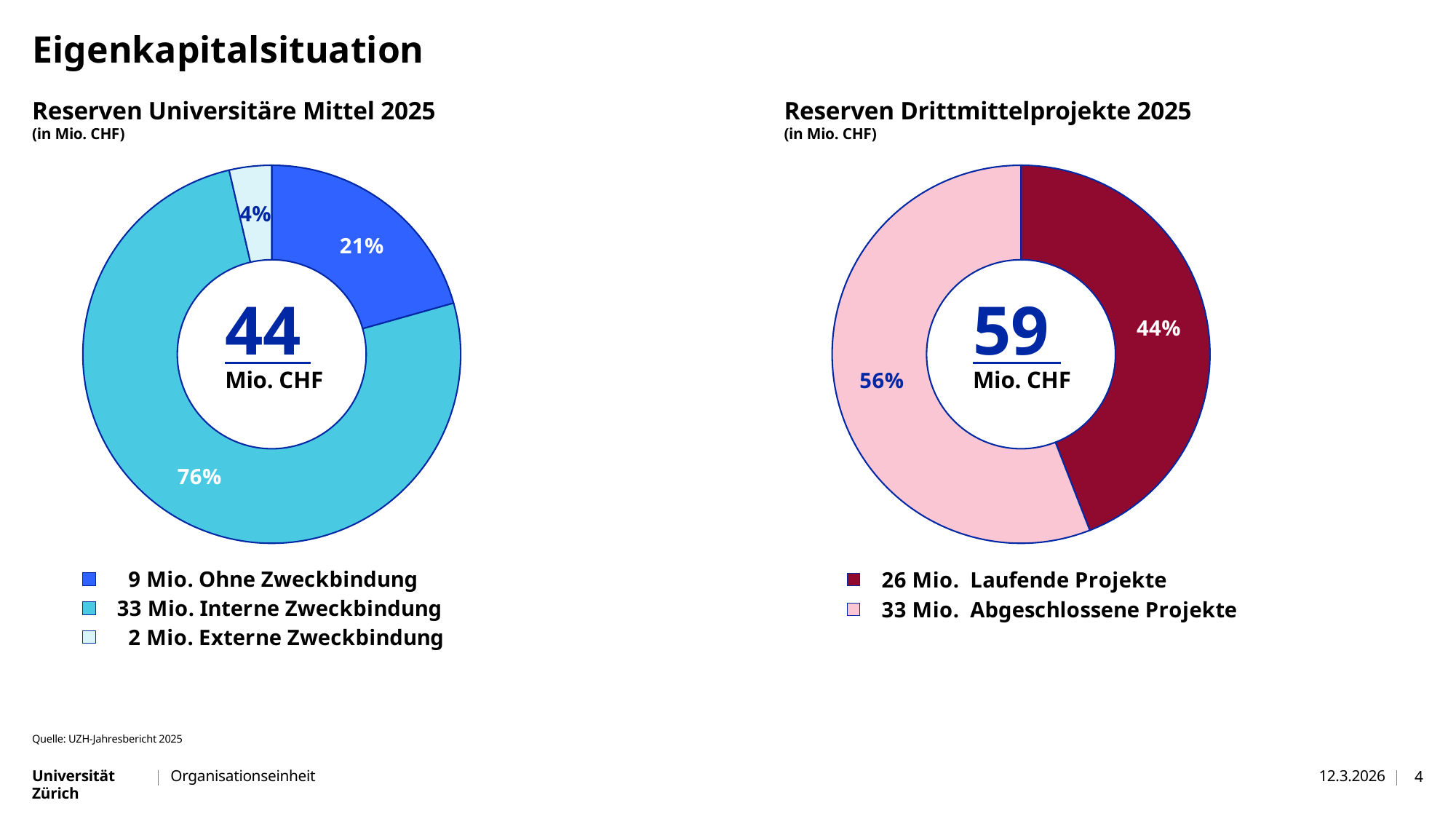
In the 'Reserven Universitäre Mittel 2025' chart, what share does Interne Zweckbindung have? 76% In the 'Reserven Universitäre Mittel 2025' chart, what is the difference between Interne Zweckbindung and Ohne Zweckbindung? 24 Mio. In the 'Reserven Universitäre Mittel 2025' chart, what is the total shown in the centre? 44 Mio. CHF In the 'Reserven Drittmittelprojekte 2025' chart, what is the value for Abgeschlossene Projekte? 33 Mio. How many categories does the 'Reserven Universitäre Mittel 2025' chart show? 3 In the 'Reserven Drittmittelprojekte 2025' chart, which is larger: Laufende Projekte or Abgeschlossene Projekte? Abgeschlossene Projekte What kind of chart is 'Reserven Drittmittelprojekte 2025'? Donut (pie) chart In the 'Reserven Universitäre Mittel 2025' chart, what is the value for Ohne Zweckbindung? 9 Mio. In the 'Reserven Drittmittelprojekte 2025' chart, what share do Laufende Projekte have? 44% In the 'Reserven Universitäre Mittel 2025' chart, which category is the smallest? Externe Zweckbindung In the 'Reserven Universitäre Mittel 2025' chart, which category is the largest? Interne Zweckbindung In the 'Reserven Drittmittelprojekte 2025' chart, what is the difference between Abgeschlossene Projekte and Laufende Projekte? 7 Mio.